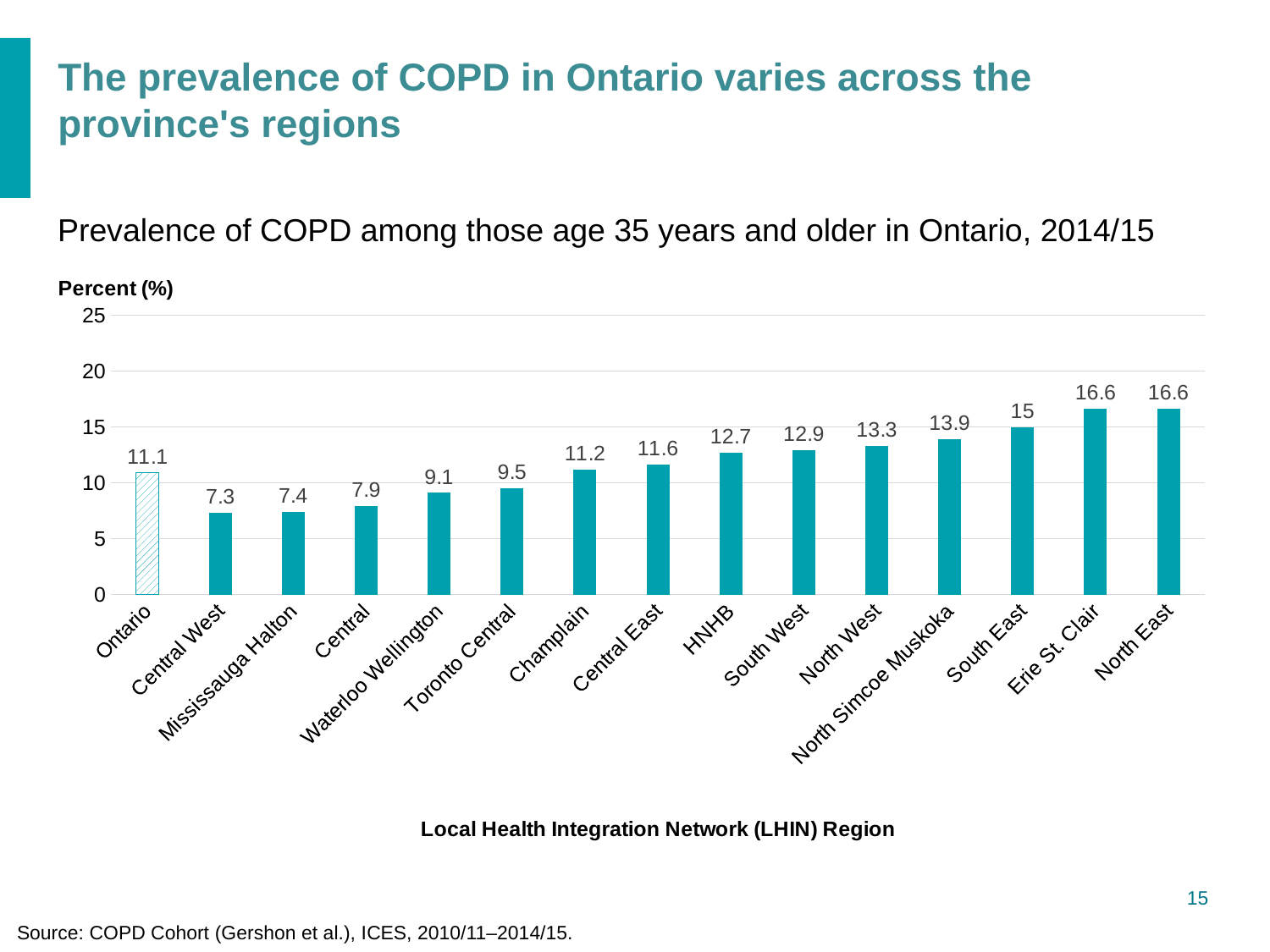
What is the difference between the values for South East and Central West? 7.7 What kind of chart is shown on the slide? bar chart How many bars are shown in the chart? 15 Is the value for Waterloo Wellington greater or less than 10? less What is the difference between the values for North East and Ontario? 5.5 What is the prevalence of COPD for Ontario overall? 11.1 Which has a higher value, Champlain or North West? North West What is the value for South East? 15 What is the title of the vertical axis? Percent (%) What is the value for North Simcoe Muskoka? 13.9 What is the value for HNHB? 12.7 What is the value for Toronto Central? 9.5